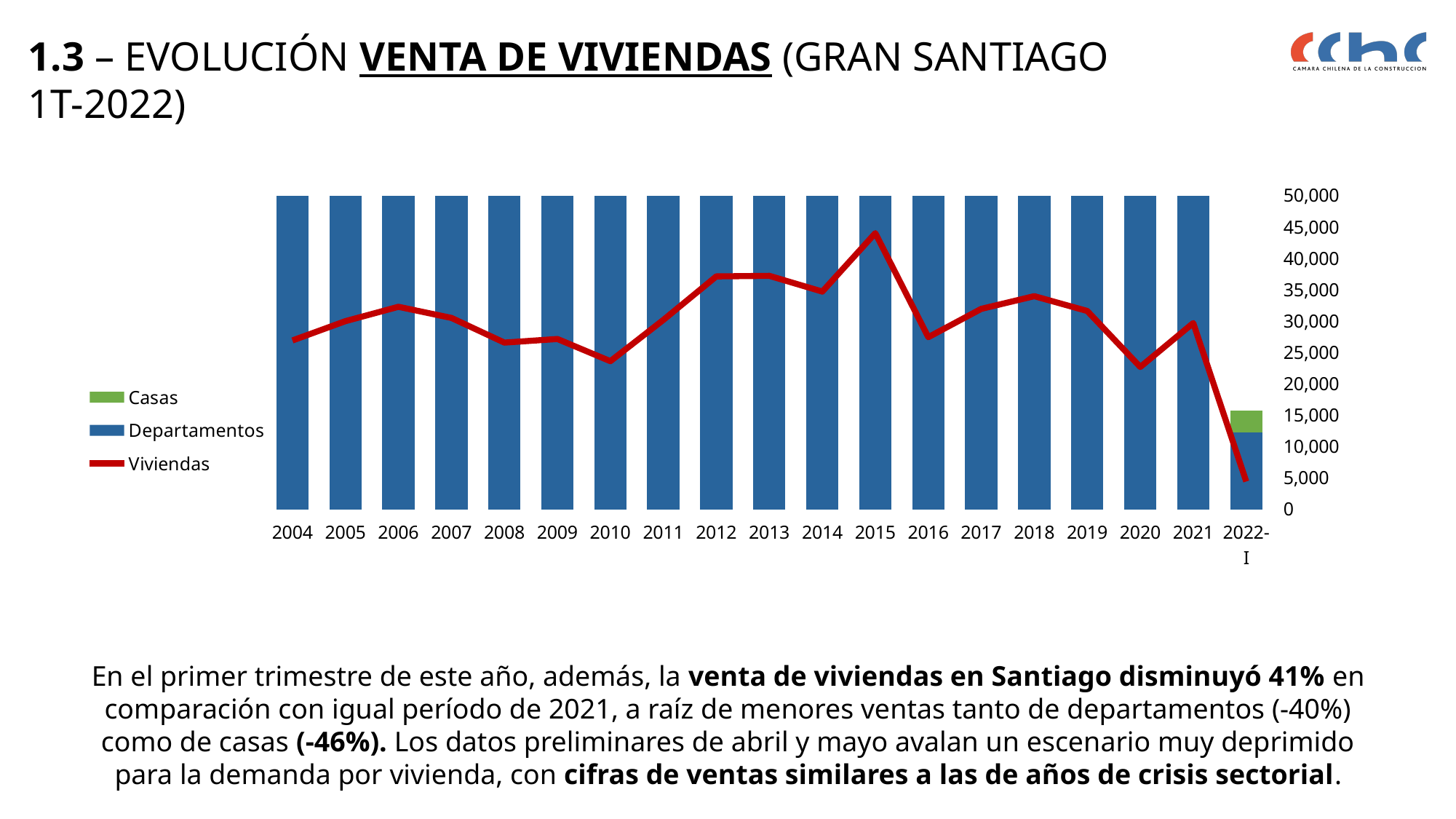
What colour represents the Casas series in the legend? Green Is the Viviendas value for 2020 greater or less than 25,000? less Is the Viviendas value for 2022-I greater or less than 10,000? less In which year does the Viviendas line reach its highest value? 2015 How many series does the legend list? 3 Does the Viviendas line rise or fall from 2021 to 2022-I? Fall Is the Viviendas value for 2015 greater or less than 40,000? greater What kind of chart is shown on the slide? A combined bar and line chart Which year has the larger Viviendas value, 2015 or 2016? 2015 In which period does the Viviendas line reach its lowest value? 2022-I Which year has the larger Viviendas value, 2006 or 2010? 2006 How many categories are shown along the x axis? 19